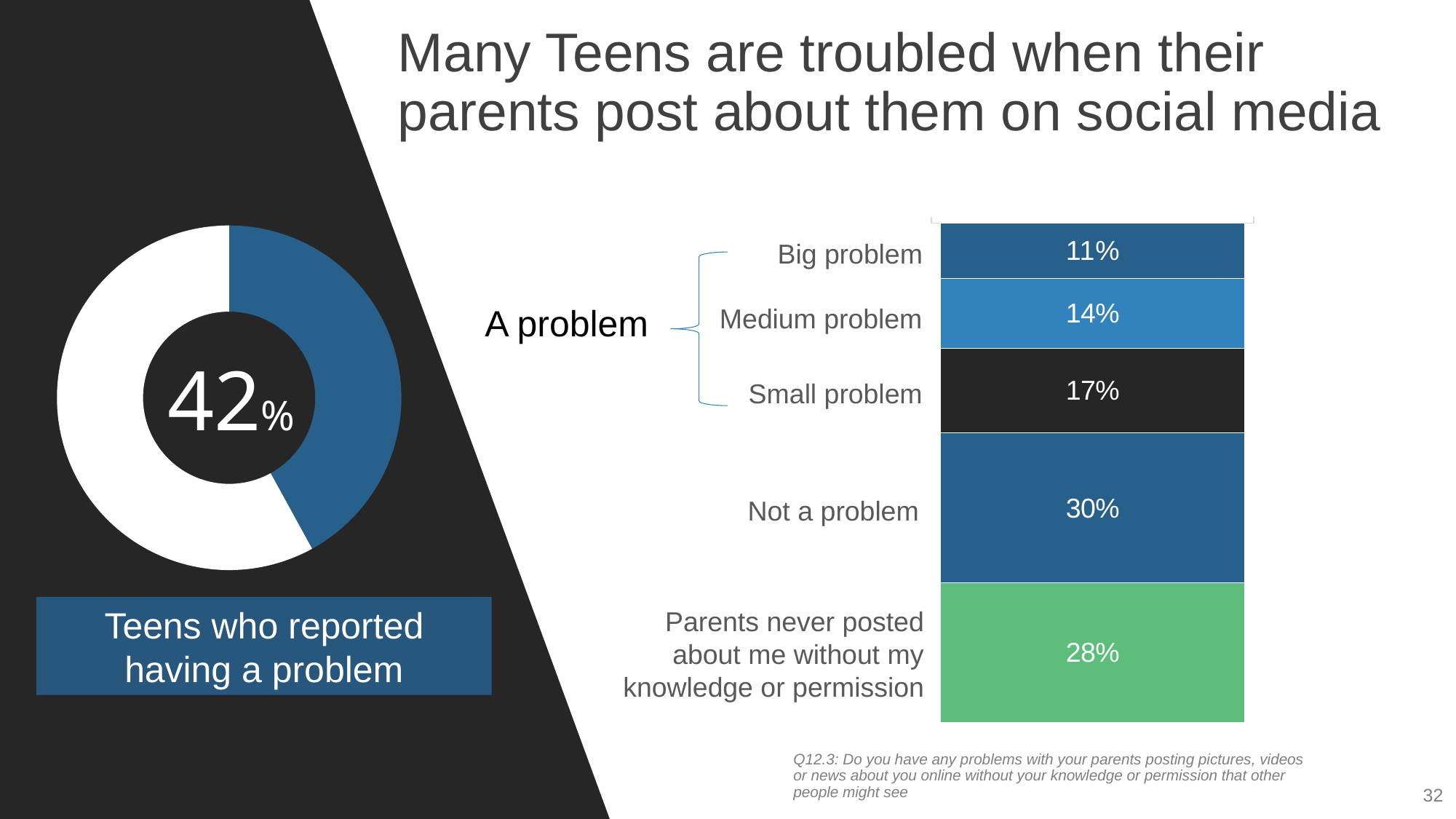
In the stacked bar chart on the right, which is larger: 'Small problem' or 'Medium problem'? Small problem In the stacked bar chart on the right, what percentage of teens said their parents never posted about them without their knowledge or permission? 28% In the stacked bar chart on the right, which category has the largest share? Not a problem In the stacked bar chart on the right, what percentage of teens said it was a medium problem? 14% What value is shown in the centre of the donut chart on the left? 42% In the stacked bar chart on the right, what is the difference between the 'Not a problem' and 'Big problem' percentages? 19% In the stacked bar chart on the right, what percentage of teens said it was a small problem? 17% In the stacked bar chart on the right, which category has the smallest share? Big problem In the stacked bar chart on the right, what percentage of teens said it was not a problem? 30% In the stacked bar chart on the right, what percentage of teens said it was a big problem? 11% How many segments does the stacked bar chart on the right have? 5 What type of chart is shown on the left side of the slide? Donut chart